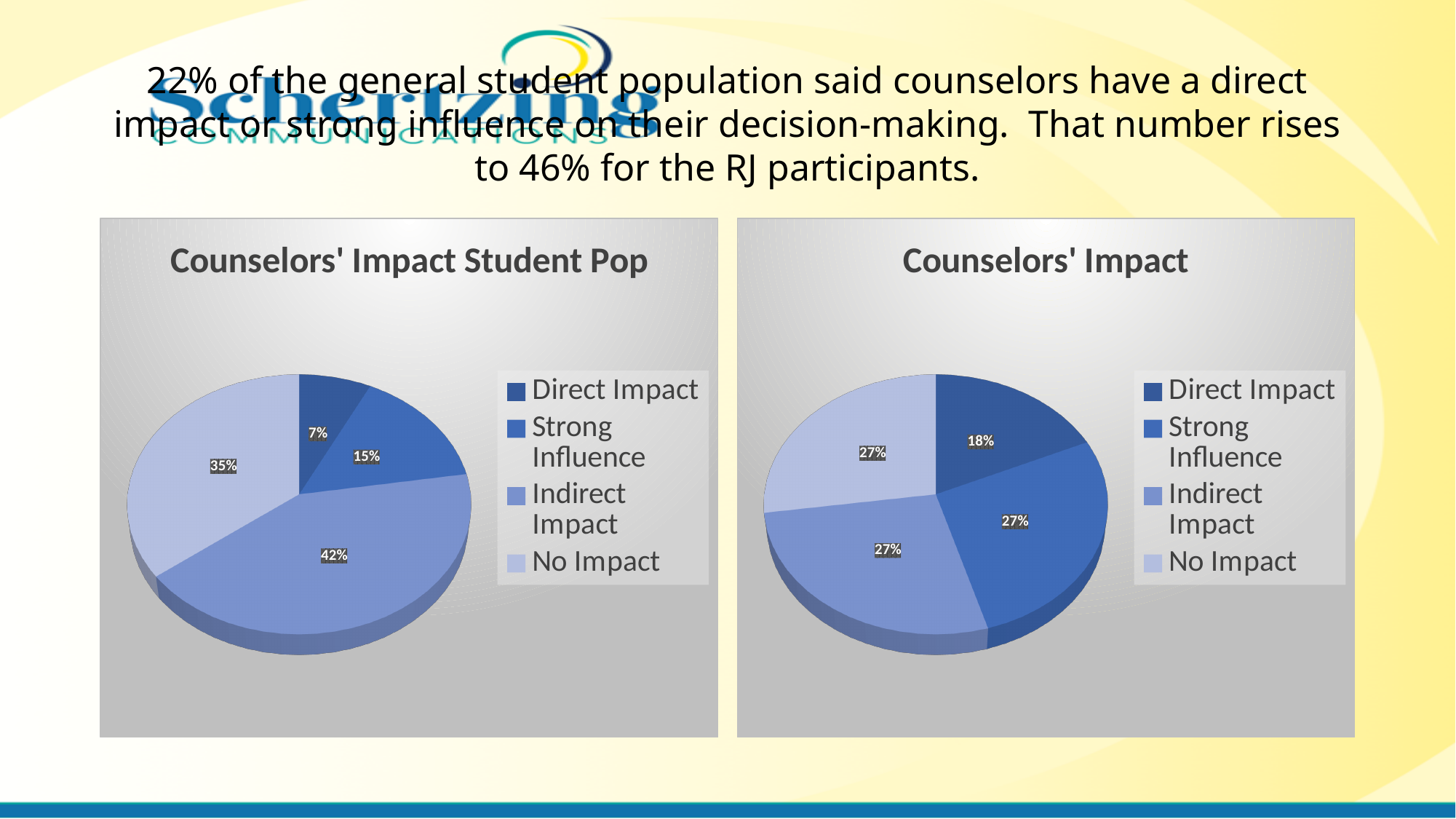
In the 'Counselors' Impact' chart on the right, what share of the pie is Direct Impact? 18% In the 'Counselors' Impact Student Pop' chart, what is the difference between the Indirect Impact and No Impact shares? 7% In the 'Counselors' Impact Student Pop' chart, which category has the largest slice? Indirect Impact In the 'Counselors' Impact Student Pop' chart, what share of the pie is No Impact? 35% In the 'Counselors' Impact Student Pop' chart, what share of the pie is Direct Impact? 7% Which is larger in the 'Counselors' Impact Student Pop' chart: Strong Influence or Direct Impact? Strong Influence In the 'Counselors' Impact Student Pop' chart, which category has the smallest slice? Direct Impact In the 'Counselors' Impact Student Pop' chart, what share of the pie is Indirect Impact? 42% In the 'Counselors' Impact' chart on the right, which category has the smallest slice? Direct Impact How many categories does the legend of the 'Counselors' Impact Student Pop' chart list? 4 What type of chart is the 'Counselors' Impact' chart on the right? Pie chart In the 'Counselors' Impact' chart on the right, what share of the pie is Strong Influence? 27%